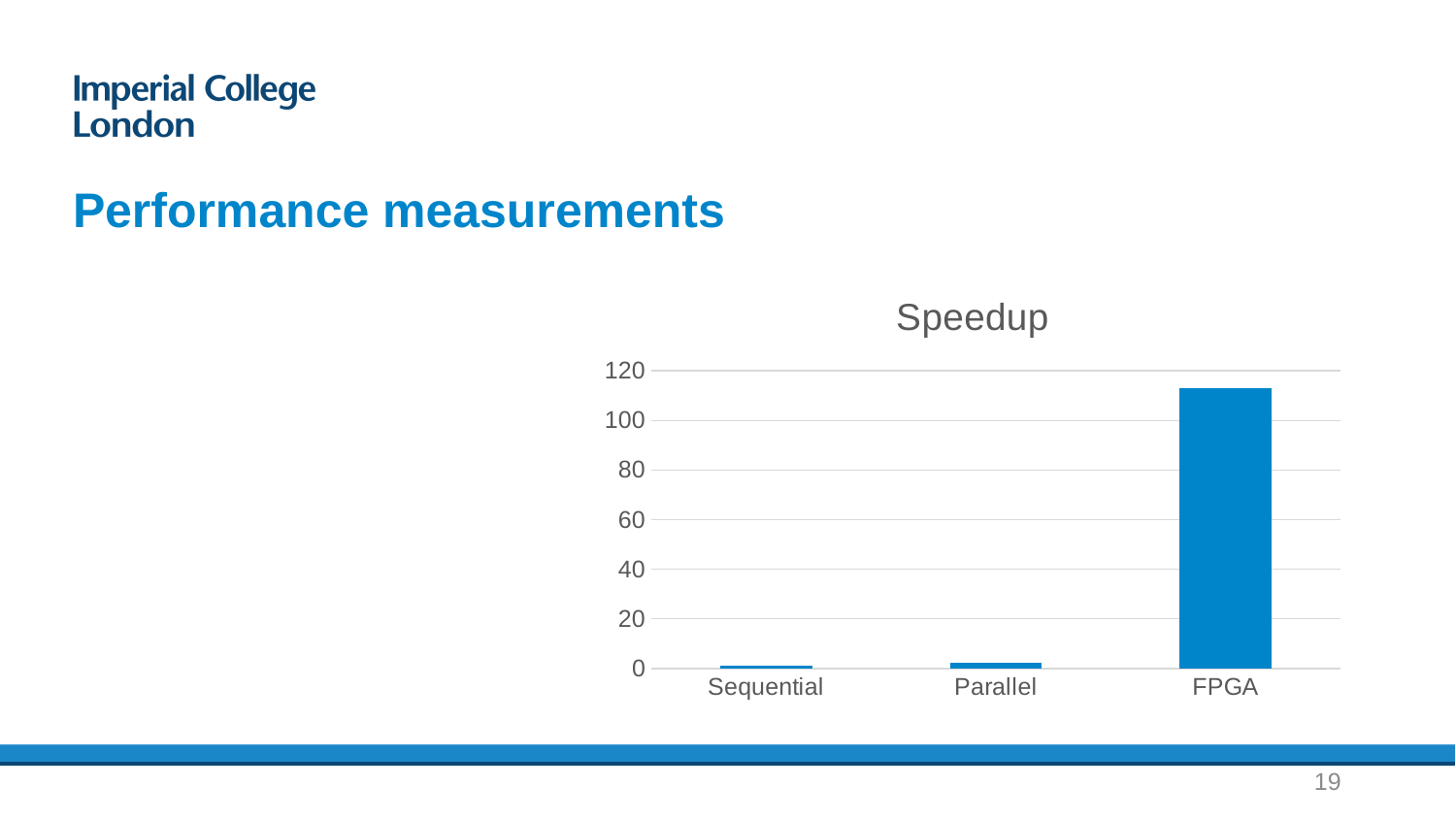
Is the value for Sequential greater or less than 20? less Which category has the highest speedup? FPGA Which has a larger speedup, Parallel or FPGA? FPGA Which category has the lowest speedup? Sequential Do the values rise or fall moving from Sequential to FPGA along the x axis? rise Is the value for FPGA greater or less than 100? greater What is the title of the chart? Speedup What kind of chart is shown on the slide? bar chart How many categories are shown on the x axis of the Speedup chart? 3 Is the value for Parallel greater or less than 20? less Which has a larger speedup, Sequential or Parallel? Parallel